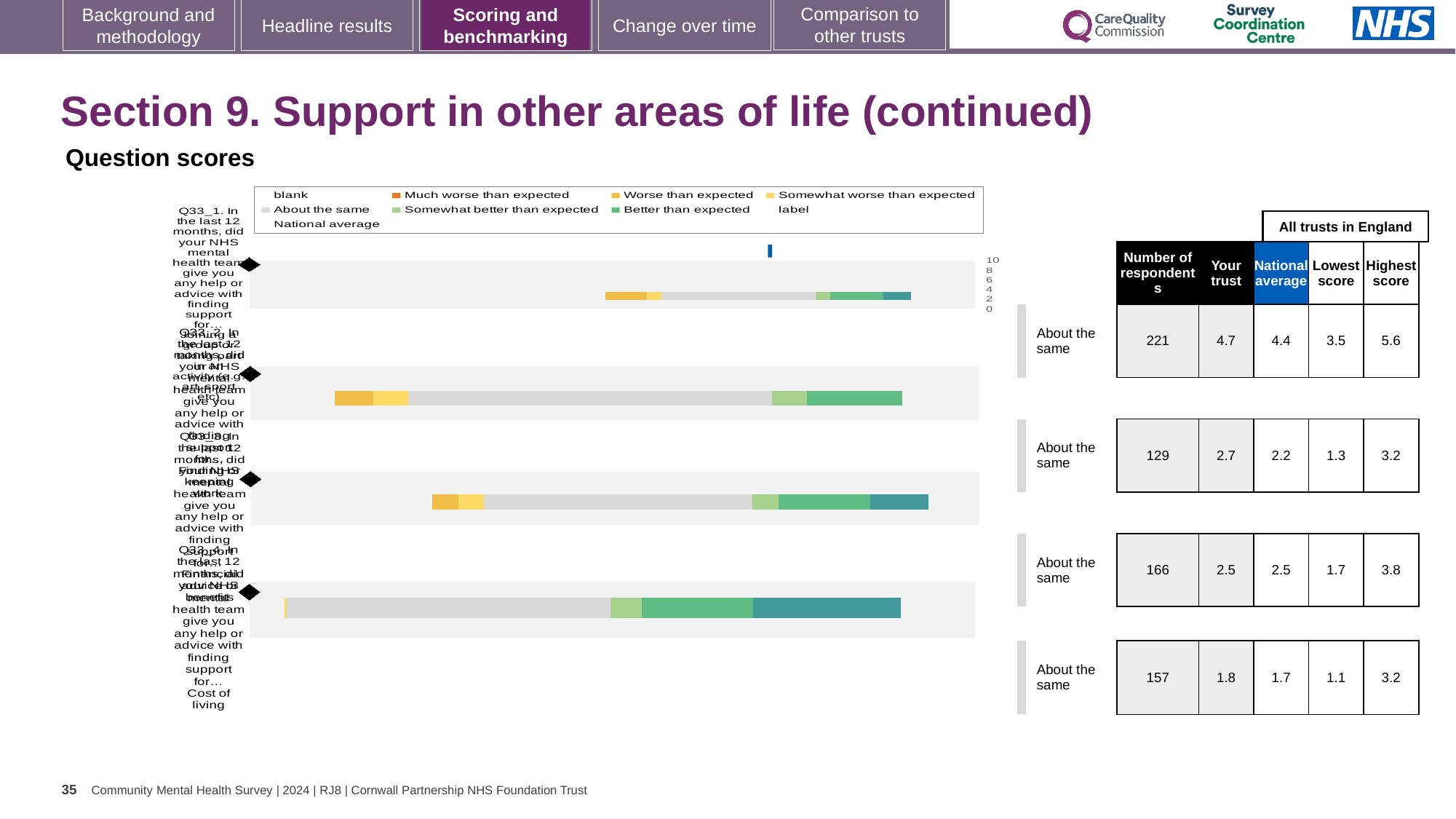
What kind of chart is shown on the slide? bar chart What is the heading above the Lowest score and Highest score columns in the table beside the chart? All trusts in England In the table beside the chart, which question row has the highest Your trust score? Q33_1 (first row) In the table beside the chart, what is the Lowest score for the fourth question row (Q33_4, Cost of living)? 1.1 How many entries does the chart legend list? 9 Which legend entry is shown in dark orange? Much worse than expected In the table beside the chart, what is the Your trust score for the first question row (Q33_1)? 4.7 In the table beside the chart, what is the National average for the second question row (Q33_2)? 2.2 In the table beside the chart, what is the number of respondents for the first question row (Q33_1)? 221 In the table beside the chart, what is the difference between the Your trust score and the National average for the second question row (Q33_2)? 0.5 How many bars (question rows) does the chart show? 4 In the table beside the chart, what is the Highest score for the third question row (Q33_3)? 3.8